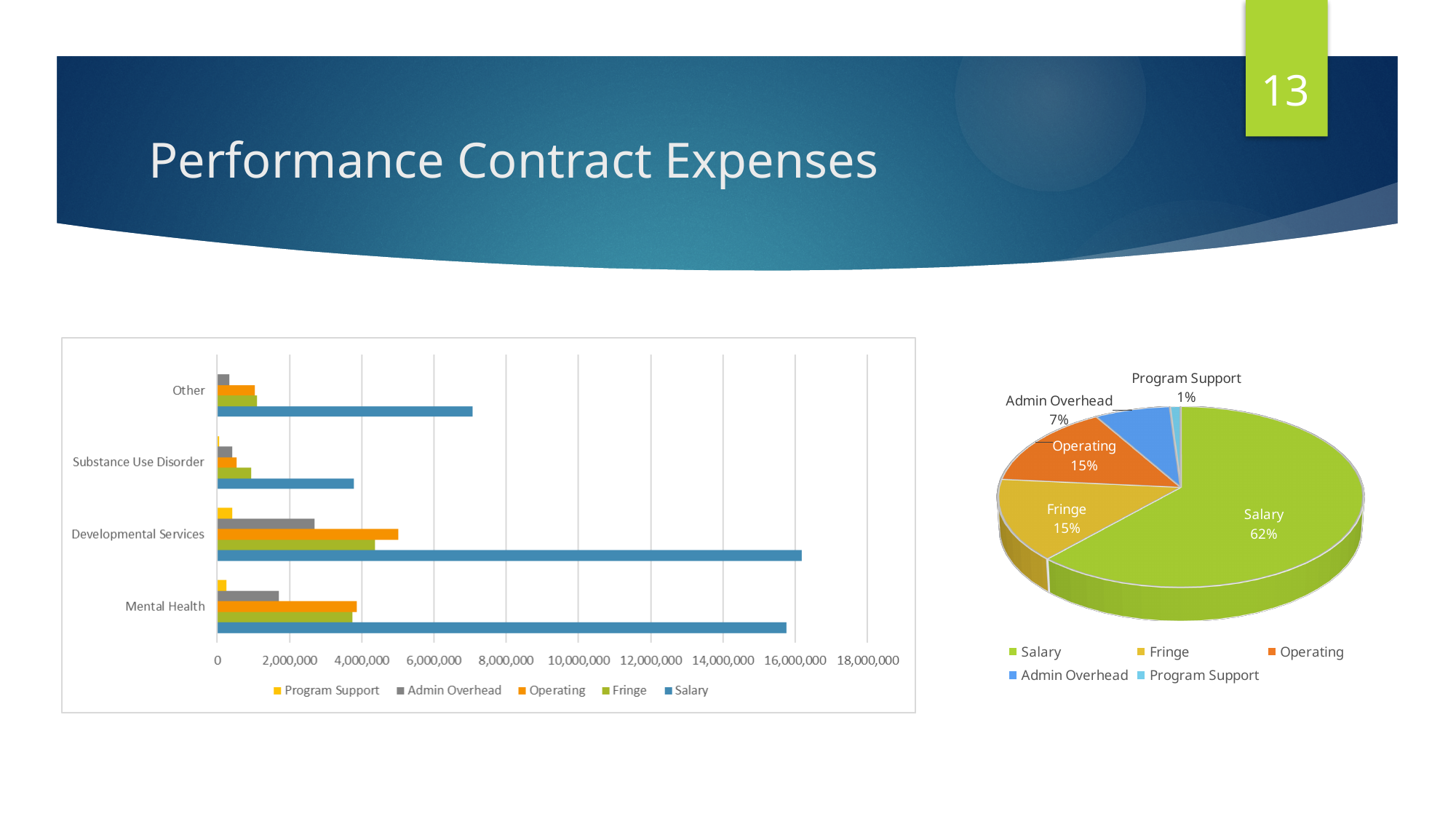
In the pie chart, what percentage is Admin Overhead? 7% In the pie chart, what share of expenses is Salary? 62% In the pie chart, which category has the largest slice? Salary How many slices does the pie chart have? 5 In the pie chart, which category has the smallest slice? Program Support In the bar chart on the left, is the Salary value for Developmental Services greater or less than 14,000,000? greater In the pie chart, how many percentage points larger is Salary than Admin Overhead? 55 percentage points How many categories are shown on the bar chart on the left? 4 In the bar chart on the left, which category has the lowest Salary value? Substance Use Disorder How many series does the legend of the bar chart on the left list? 5 In the pie chart, what percentage is Program Support? 1% What kind of chart is the chart on the left of the slide? Bar chart